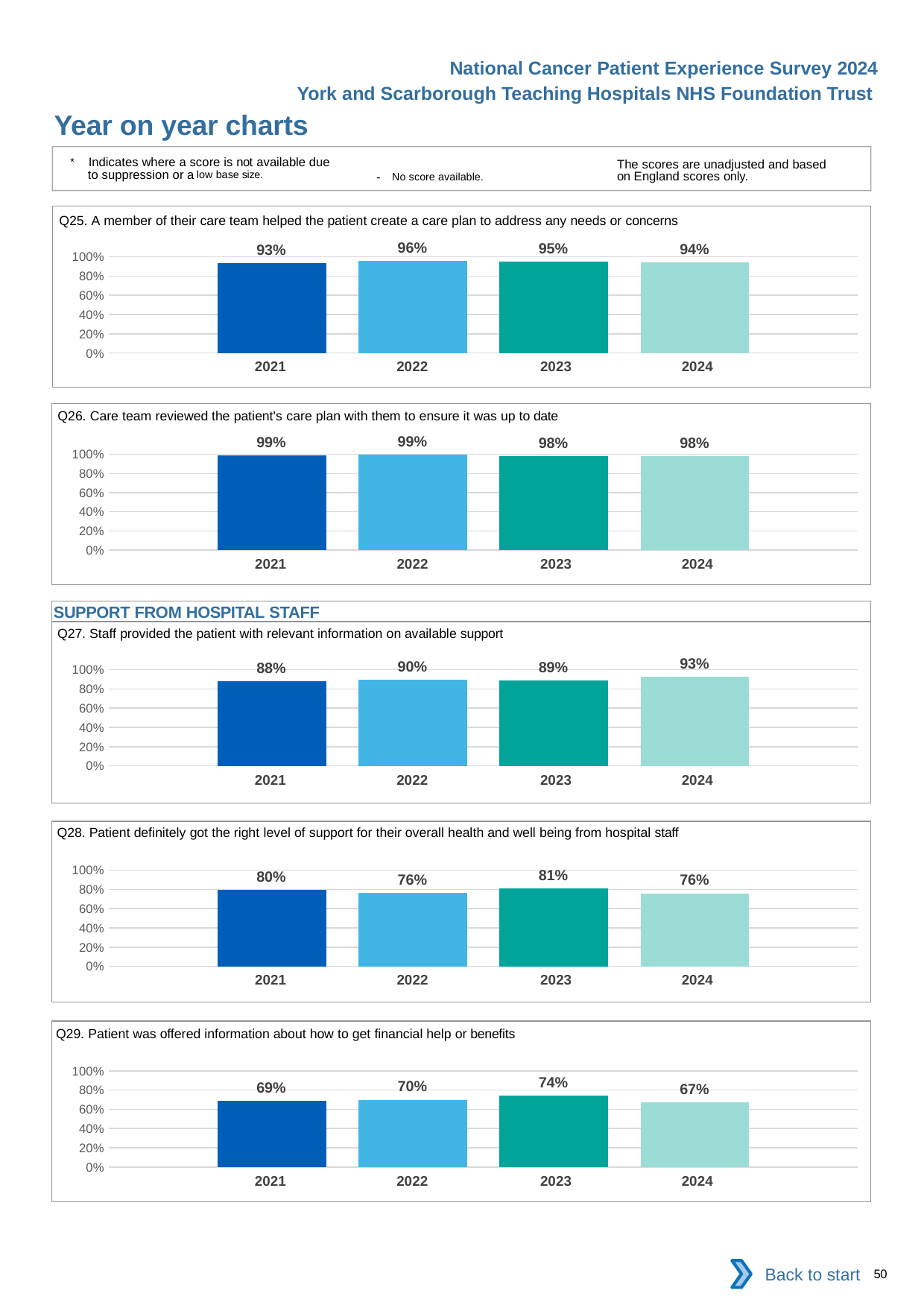
In the Q26 chart, which year has the lowest value? 2023 and 2024 (both 98%) In the Q29 chart, is the value for 2021 greater or less than 80%? less What kind of chart is the Q26 chart? bar chart In the Q29 chart, what is the difference between the 2023 value and the 2024 value? 7 percentage points In the Q27 chart, what is the difference between the 2024 value and the 2021 value? 5 percentage points In the Q29 chart, which year has the lowest value? 2024 In the Q27 chart, which year has the highest value? 2024 In the Q25 chart, what is the value for 2021? 93% In the Q28 chart, is the value for 2021 larger or smaller than the value for 2022? larger How many years are shown on the x axis of the Q25 chart? 4 In the Q25 chart, what is the value for 2022? 96% In the Q28 chart, what is the value for 2023? 81%